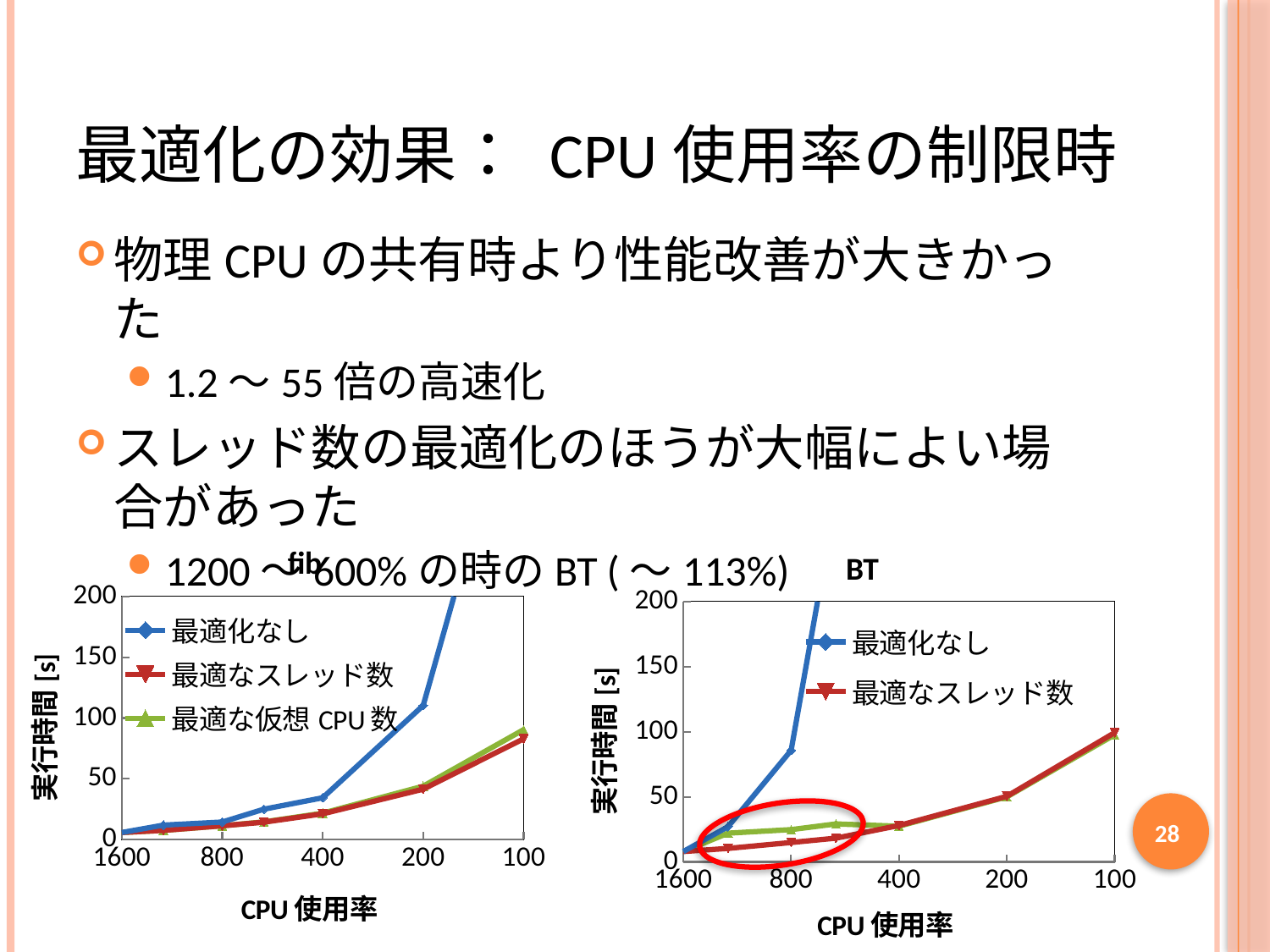
In the right chart (BT), is the value of 最適化なし at CPU 使用率 800 greater or less than 50? greater What kind of chart is the left chart (fib)? line chart In the left chart (fib), is the value of 最適化なし at CPU 使用率 200 greater or less than 100? greater In the left chart (fib), is the value of 最適化なし at CPU 使用率 400 greater or less than 50? less How many tick labels are shown on the x axis of the right chart (BT)? 5 In the left chart (fib), which series has the highest value at CPU 使用率 200? 最適化なし How many series does the legend of the left chart (fib) list? 3 In the right chart (BT), do the values of 最適なスレッド数 rise or fall moving from left to right along the x axis (from 1600 to 100)? rise How many series does the legend of the right chart (BT) list? 2 In the right chart (BT), at CPU 使用率 800, which is larger: 最適化なし or 最適なスレッド数? 最適化なし What is the y-axis label of the right chart (BT)? 実行時間 [s]